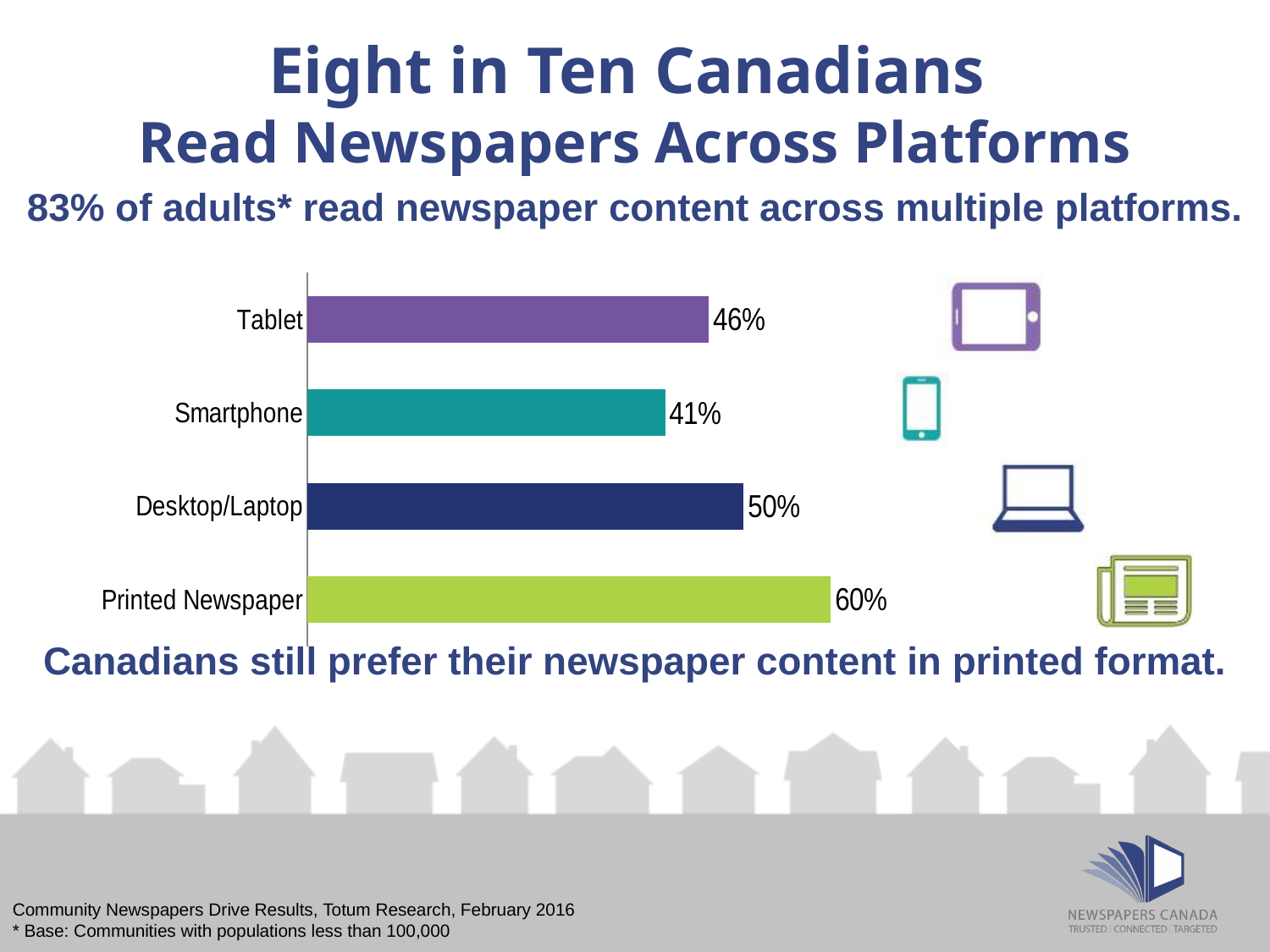
What percentage of adults read newspaper content on a tablet? 46% What is the value shown for Smartphone? 41% What is the difference between the Tablet value and the Smartphone value? 5% What is the difference between the Printed Newspaper value and the Desktop/Laptop value? 10% Which platform has the highest value in the chart? Printed Newspaper What kind of chart is shown on the slide? Bar chart How many platforms are shown in the chart? 4 What is the value shown for Printed Newspaper? 60% What colour is the bar for Printed Newspaper? Green What is the value shown for Desktop/Laptop? 50% Which platform has the lowest value in the chart? Smartphone Which is larger, the value for Tablet or the value for Desktop/Laptop? Desktop/Laptop